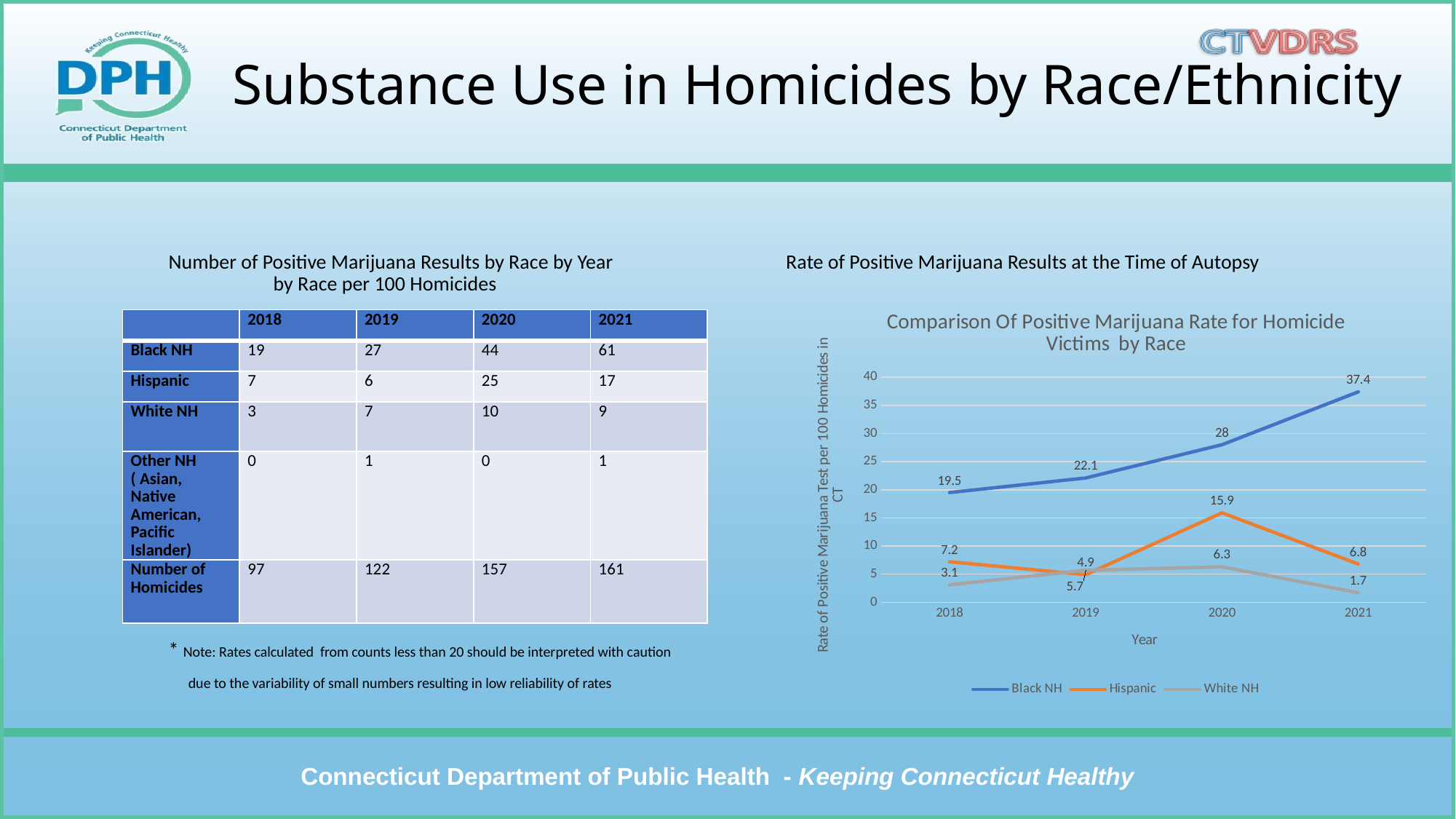
What is the title of the x axis of the chart? Year What kind of chart is shown on the slide? line chart In which year is the White NH rate lowest? 2021 In which year is the Black NH rate highest? 2021 What is the positive marijuana rate for Black NH homicide victims in 2021? 37.4 By how much did the Black NH rate increase from 2018 to 2021? 17.9 How many years are shown on the x axis of the chart? 4 What is the positive marijuana rate for White NH homicide victims in 2018? 3.1 What is the positive marijuana rate for Hispanic homicide victims in 2020? 15.9 How many series does the legend of the chart list? 3 Does the Black NH rate rise or fall from 2018 to 2021? rise In 2020, which series has the higher rate, Hispanic or White NH? Hispanic